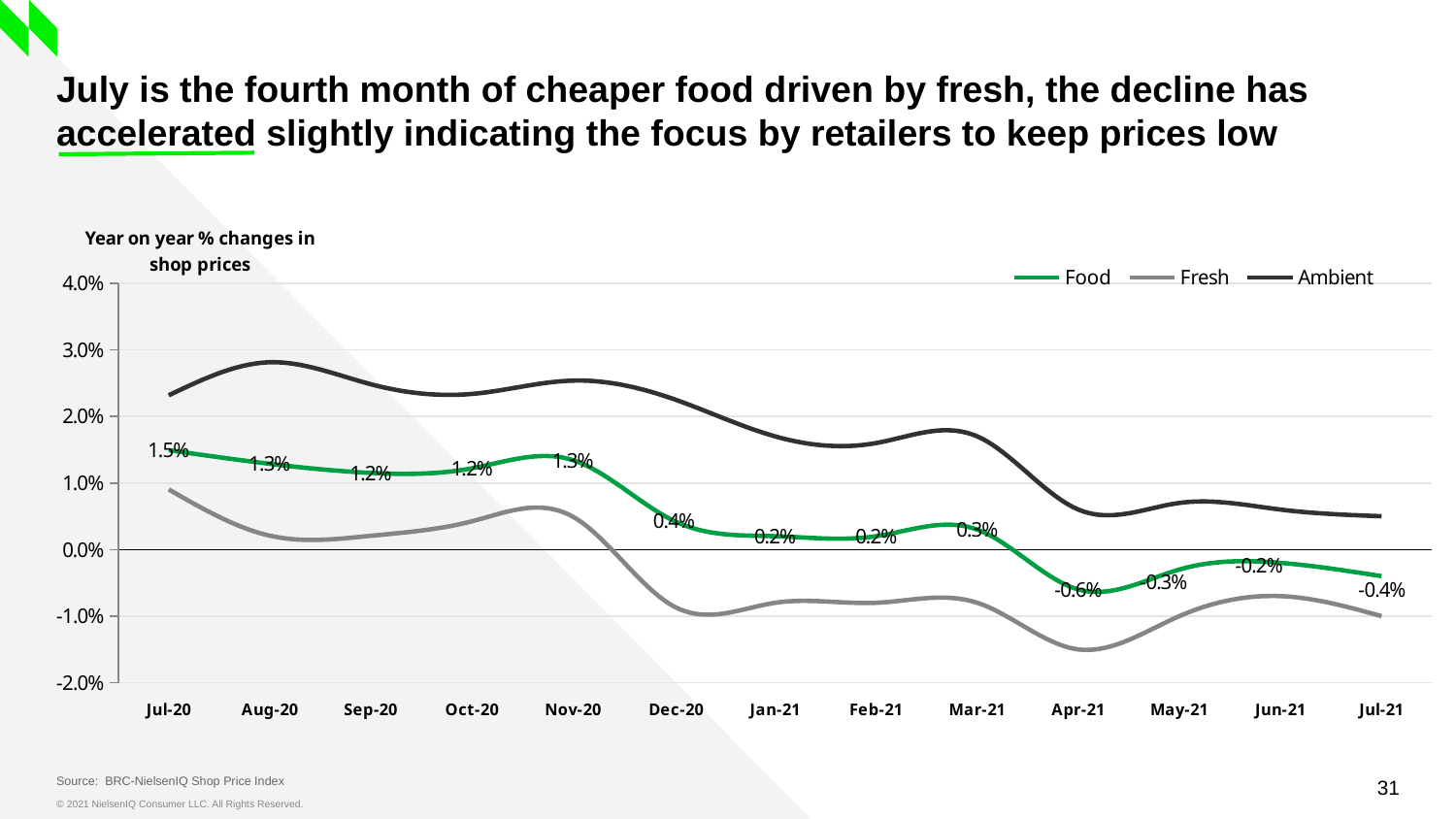
What is the difference between the Food value in Jul-20 and in Jul-21? 1.9 percentage points Is the Fresh value for Apr-21 greater or less than -1.0%? less What is the Food value for Dec-20? 0.4% In which month is the Food series lowest? Apr-21 In which month is the Food series highest? Jul-20 Is the Ambient value for Aug-20 greater or less than 2.0%? greater How many months are shown on the x axis? 13 What is the Food value for Jul-20? 1.5% What is the Food value for Apr-21? -0.6% What is the Food value for Jul-21? -0.4% How many series does the legend list? 3 Which is larger, the Food value for Nov-20 or for Dec-20? Nov-20